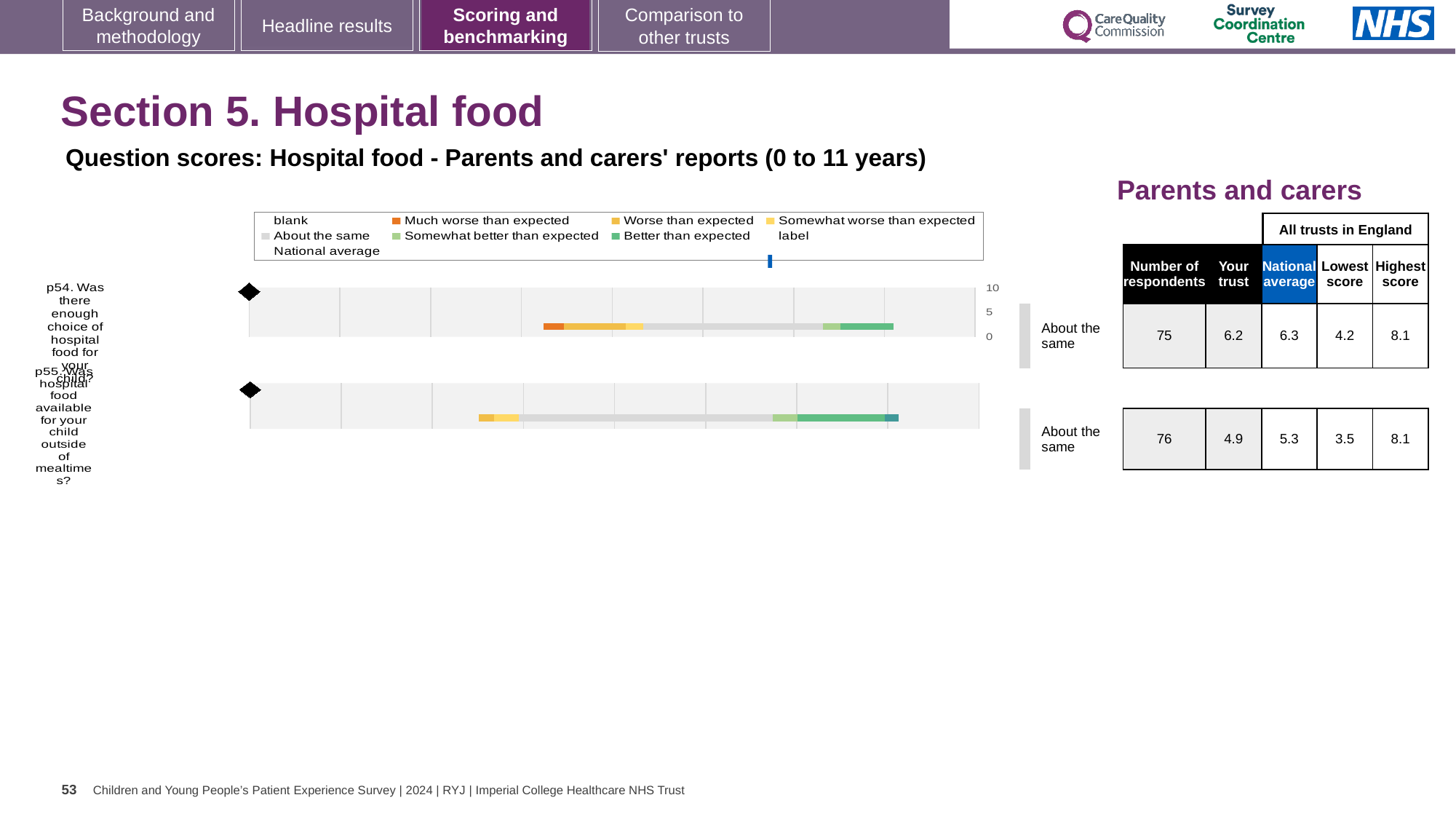
What is the national average score for p55 (hospital food available outside of mealtimes)? 5.3 Which question has the higher 'Your trust' score, p54 or p55? p54 What benchmark category is shown for both p54 and p55? About the same How many respondents answered question p54? 75 What kind of chart is used to show the question scores for hospital food? bar chart What is the difference between the national average and the 'Your trust' score for p55? 0.4 What is the difference between the highest and lowest trust scores for p55? 4.6 What is the highest score across all trusts in England for p54? 8.1 What is the lowest score across all trusts in England for p55? 3.5 What is the 'Your trust' score for p54 (enough choice of hospital food for your child)? 6.2 Which legend entry is represented by the dark blue marker? National average How many questions (categories) are plotted in the hospital food chart? 2